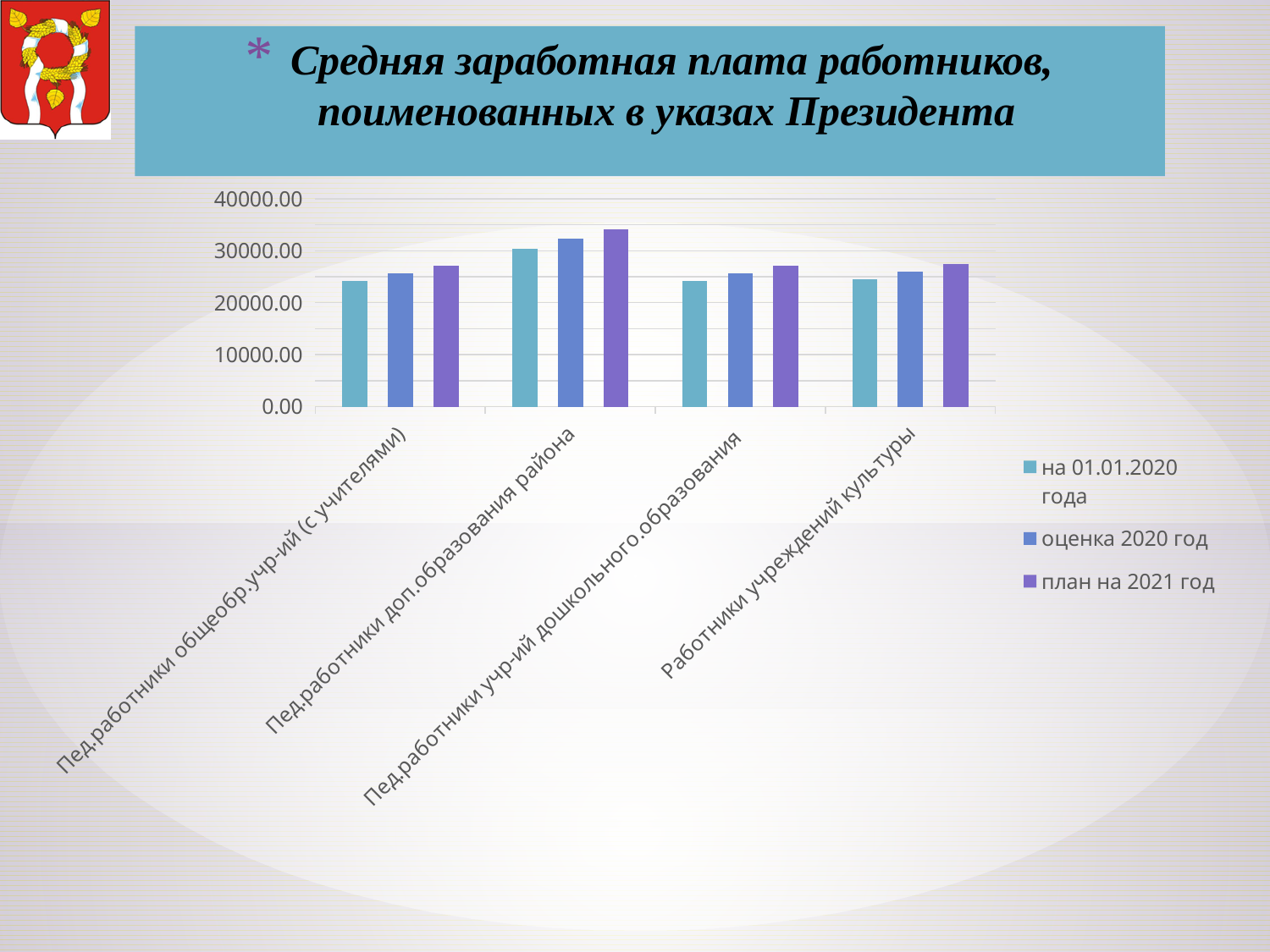
Is the value for 'Работники учреждений культуры' in the series 'план на 2021 год' greater or less than 20000.00? greater Which category has the highest value for the series 'на 01.01.2020 года'? Пед.работники доп.образования района Which series is shown in the darkest purple colour in the chart legend? план на 2021 год How many categories are shown on the x axis of the chart? 4 Which category has the highest value for the series 'план на 2021 год'? Пед.работники доп.образования района Is the value for 'Пед.работники общеобр.учр-ий (с учителями)' in the series 'на 01.01.2020 года' greater or less than 30000.00? less For the series 'оценка 2020 год', which is larger: 'Пед.работники доп.образования района' or 'Пед.работники учр-ий дошкольного.образования'? Пед.работники доп.образования района Is the value for 'Пед.работники доп.образования района' in the series 'план на 2021 год' greater or less than 30000.00? greater What is the title of the chart on the slide? Средняя заработная плата работников, поименованных в указах Президента What kind of chart is shown on the slide? bar chart For 'Пед.работники доп.образования района', do the values rise or fall from 'на 01.01.2020 года' to 'план на 2021 год'? rise How many series does the chart legend list? 3